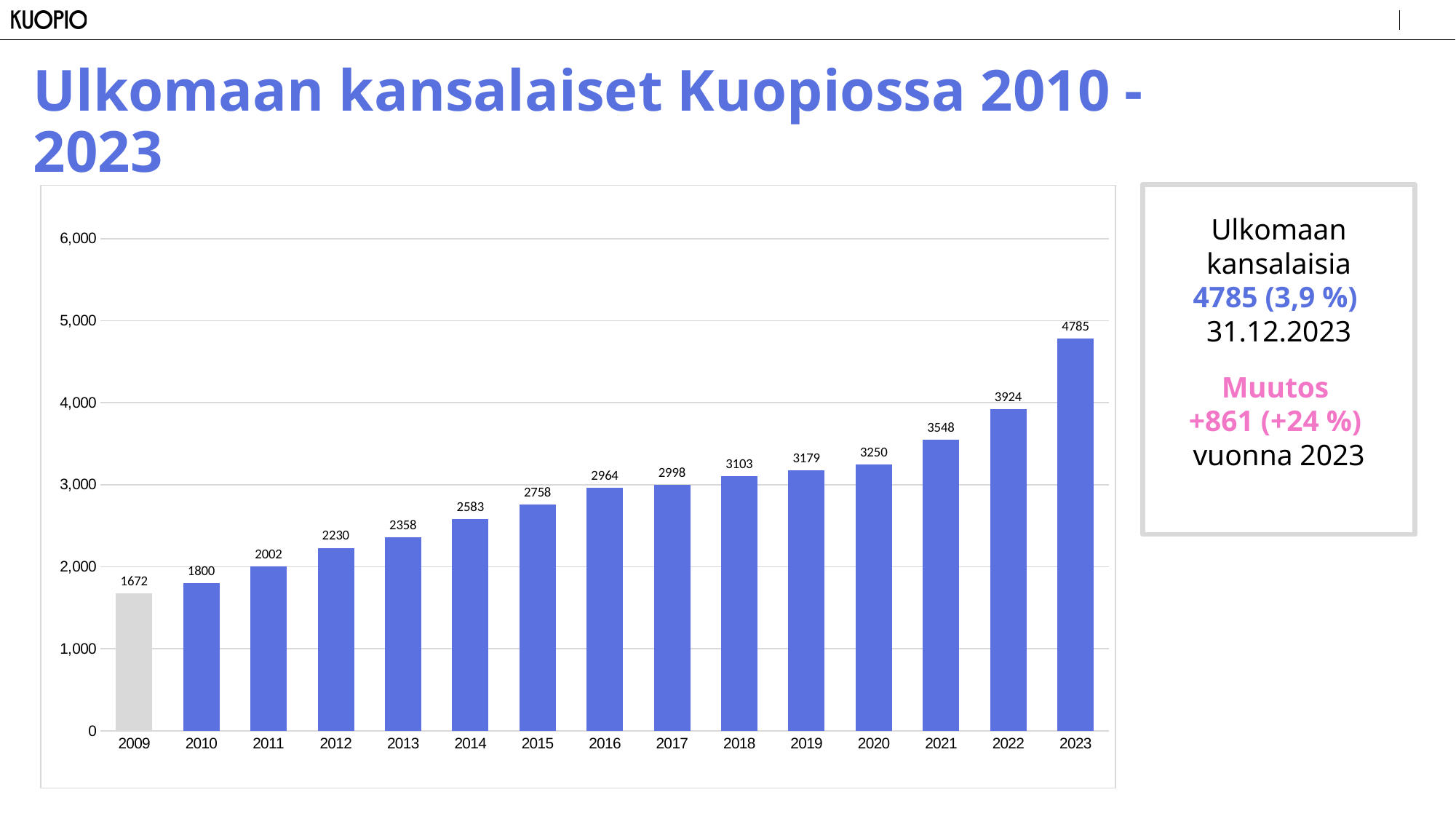
What is the value for 2015? 2758 What is the difference between the values for 2012 and 2011? 228 What is the value for 2020? 3250 How many years are shown on the x axis? 15 Is the value for 2021 greater or less than 3,000? greater What kind of chart is shown? bar chart What is the value for 2009? 1672 Which year has the lowest value? 2009 Do the values rise or fall from 2009 to 2023? rise Which is larger, the value for 2018 or the value for 2017? 2018 Which year has the highest value? 2023 What is the difference between the values for 2023 and 2022? 861